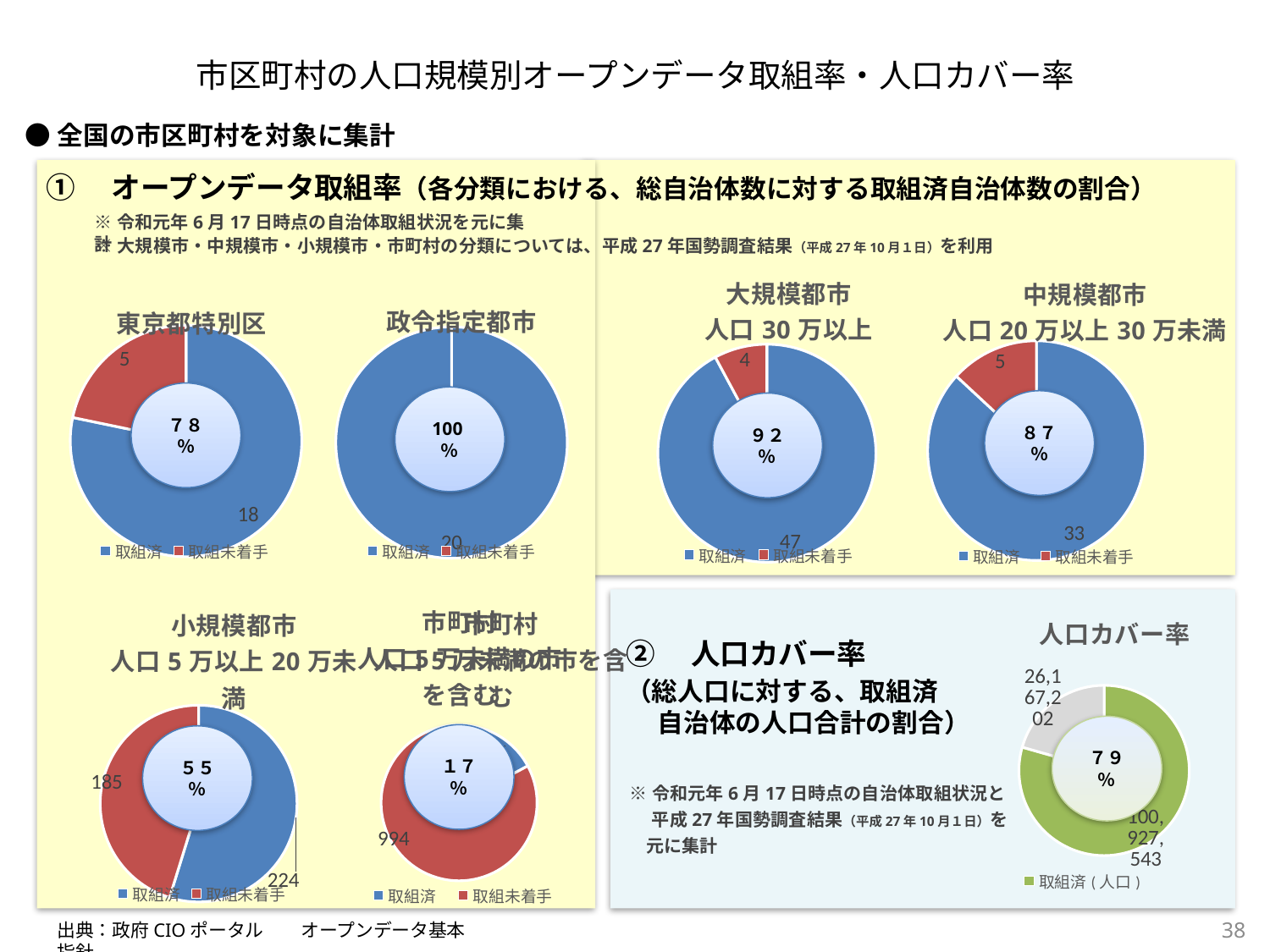
What kind of chart is used for 東京都特別区? Donut chart In the 東京都特別区 chart, which is larger, the 取組済 value or the 取組未着手 value? 取組済 In the 市町村 chart, what is the value for 取組未着手? 994 How many series does the legend of the 大規模都市 (人口30万以上) chart list? 2 In the 人口カバー率 chart, what is the value for 取組済(人口)? 100,927,543 In the 大規模都市 (人口30万以上) chart, what is the value for 取組済? 47 In the 政令指定都市 chart, what percentage is shown in the centre of the donut? 100% In the 小規模都市 (人口5万以上20万未満) chart, what is the total of the 取組済 and 取組未着手 values? 409 In the 小規模都市 (人口5万以上20万未満) chart, what is the difference between the 取組済 value and the 取組未着手 value? 39 In the 東京都特別区 chart, what percentage is shown in the centre of the donut? 78% In the 中規模都市 (人口20万以上30万未満) chart, what is the value for 取組未着手? 5 In the 人口カバー率 chart, what percentage is shown in the centre of the donut? 79%